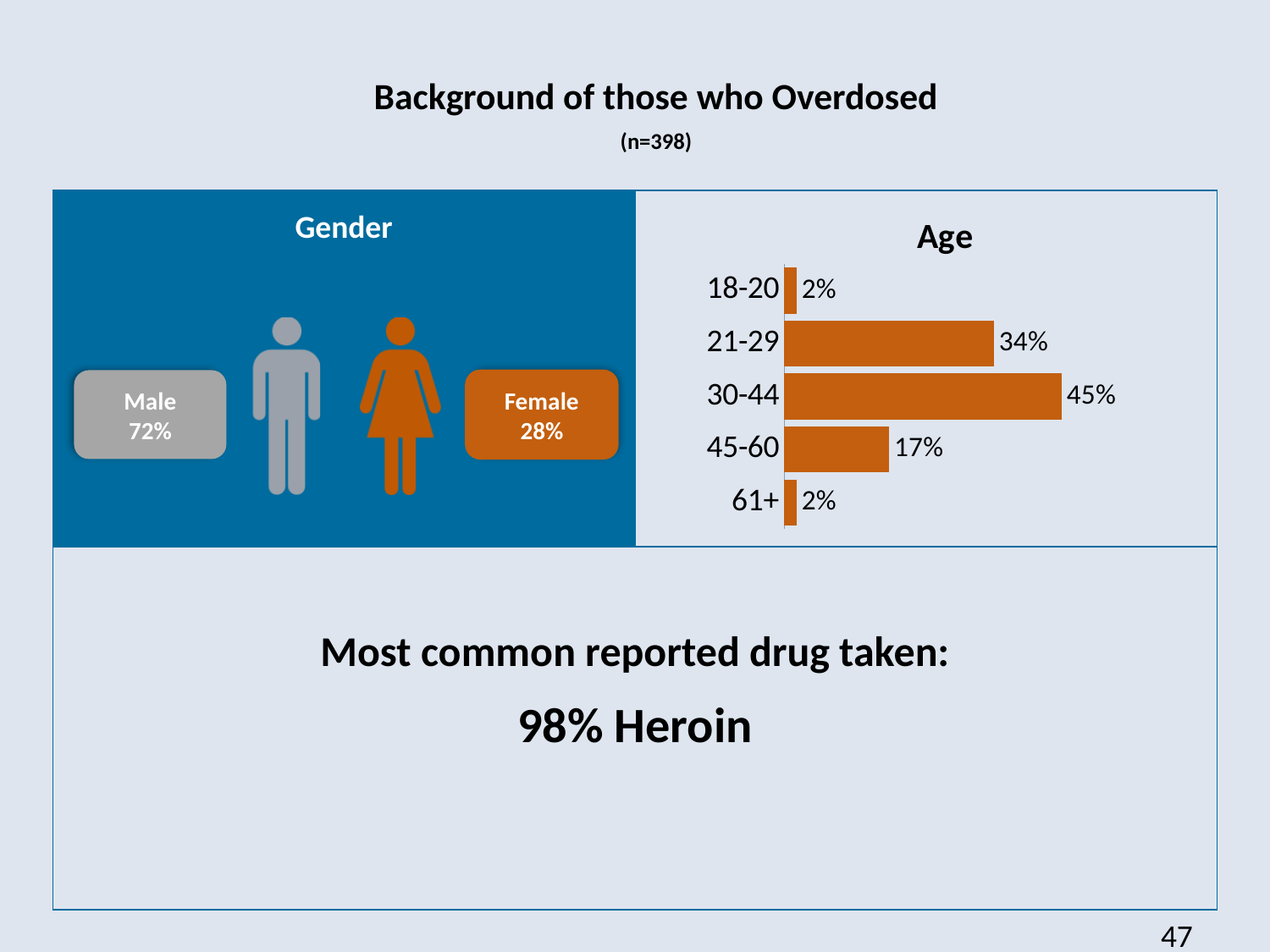
In the Age chart, what is the difference between the values for 30-44 and 21-29? 11% In the Age chart, what is the value for the 21-29 age group? 34% In the Age chart, which is larger, the value for 45-60 or the value for 21-29? 21-29 What kind of chart is the Age chart? bar chart In the Age chart, what is the difference between the values for 21-29 and 45-60? 17% What is the title of the chart on the right side of the slide? Age In the Age chart, what is the value for the 18-20 age group? 2% What colour are the bars in the Age chart? orange In the Age chart, which age group has the highest value? 30-44 In the Age chart, what is the value for the 45-60 age group? 17% In the Age chart, what is the value for the 30-44 age group? 45% How many age groups are shown in the Age chart? 5